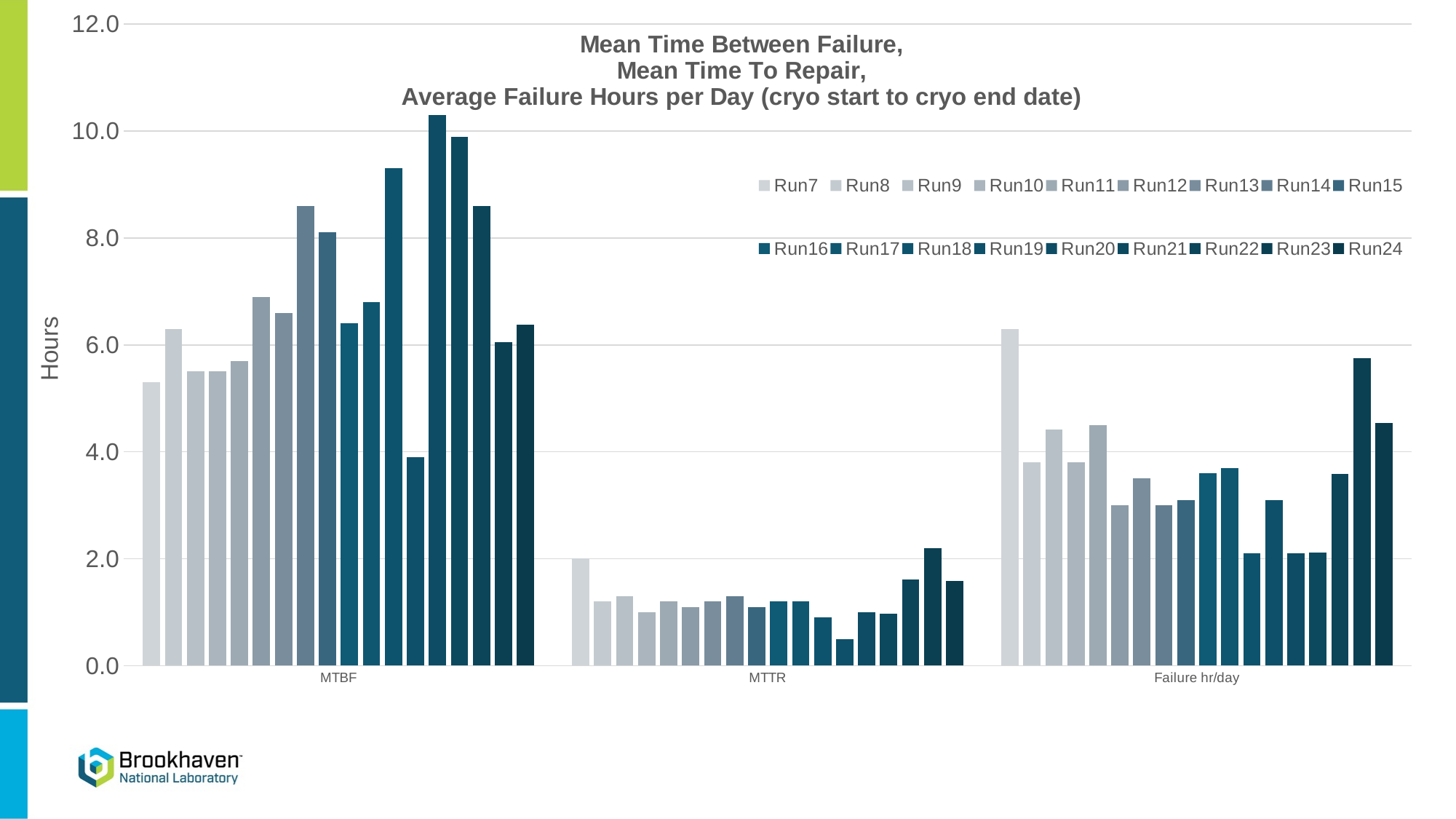
What is the highest value shown on the y axis? 12.0 Is the Run7 value for MTTR greater or less than 1.0? greater Which category has the lowest bars overall? MTTR What is the label of the y axis? Hours Is the Run24 value for Failure hr/day greater or less than 4.0? greater How many series does the legend list? 18 What kind of chart is shown on the slide? bar chart Is the tallest bar in the MTBF category greater or less than 10.0? greater Which category contains the tallest bar in the chart? MTBF How many categories are shown on the x axis? 3